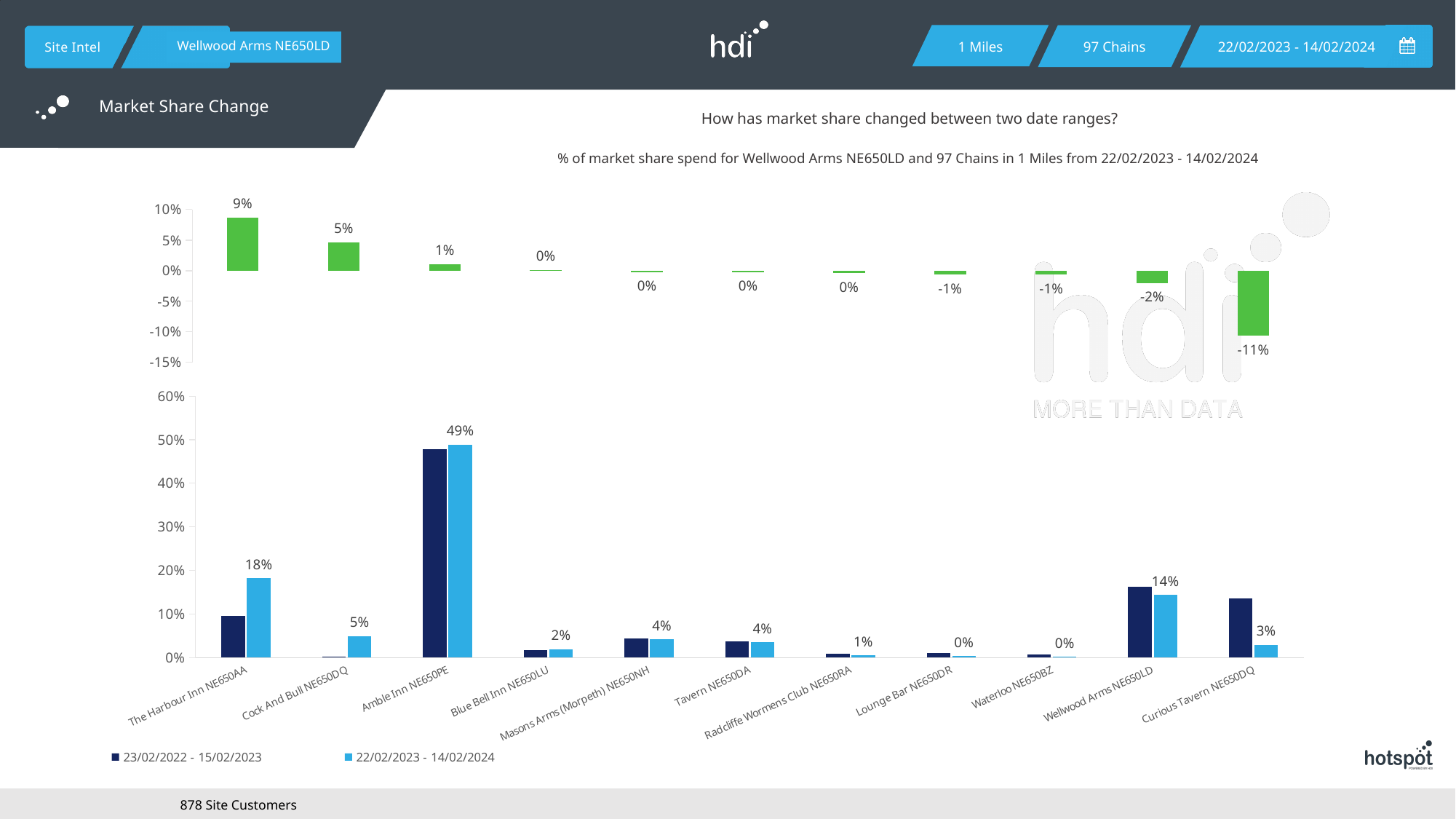
In the bottom chart, is the 23/02/2022 - 15/02/2023 value for Amble Inn NE650PE greater or less than 40%? greater In the top chart, what is the market share change for The Harbour Inn NE650AA? 9% In the top chart, which venue has the highest market share change? The Harbour Inn NE650AA In the bottom chart, how many series does the legend list? 2 In the top chart, what is the difference between the market share change for The Harbour Inn NE650AA and Cock And Bull NE650DQ? 4% In the top chart, which venue has the lowest market share change? Curious Tavern NE650DQ In the bottom chart, what is the market share for Wellwood Arms NE650LD in 22/02/2023 - 14/02/2024? 14% What type of chart is the bottom chart? Bar chart How many venues are shown on the x axis of the bottom chart? 11 In the bottom chart, which venue has the highest market share in 22/02/2023 - 14/02/2024? Amble Inn NE650PE In the top chart, what is the market share change for Curious Tavern NE650DQ? -11% In the bottom chart, what is the market share for Amble Inn NE650PE in 22/02/2023 - 14/02/2024? 49%